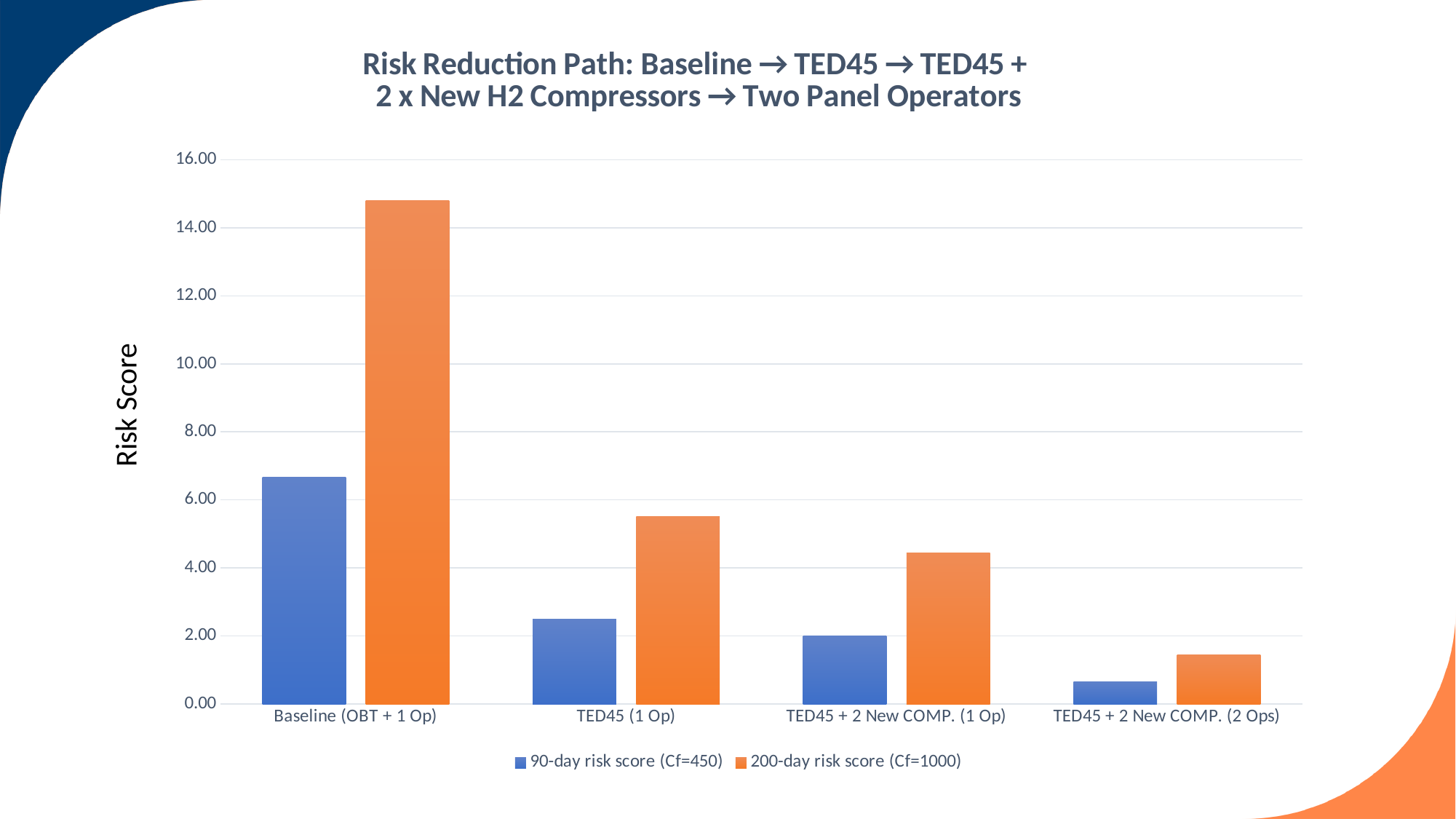
Is the 200-day risk score (Cf=1000) for TED45 (1 Op) greater or less than 4.00? greater Is the 90-day risk score (Cf=450) for Baseline (OBT + 1 Op) greater or less than 6.00? greater Which category has the highest 200-day risk score (Cf=1000)? Baseline (OBT + 1 Op) Which category has the lowest 90-day risk score (Cf=450)? TED45 + 2 New COMP. (2 Ops) Do the 200-day risk score (Cf=1000) values rise or fall from left to right across the categories? fall How many series does the legend list? 2 Is the 200-day risk score (Cf=1000) for TED45 + 2 New COMP. (2 Ops) greater or less than 2.00? less What is the label of the vertical axis? Risk Score What kind of chart is shown on the slide? bar chart How many categories are shown on the x axis? 4 Which is larger for TED45 (1 Op): the 90-day risk score (Cf=450) or the 200-day risk score (Cf=1000)? 200-day risk score (Cf=1000)